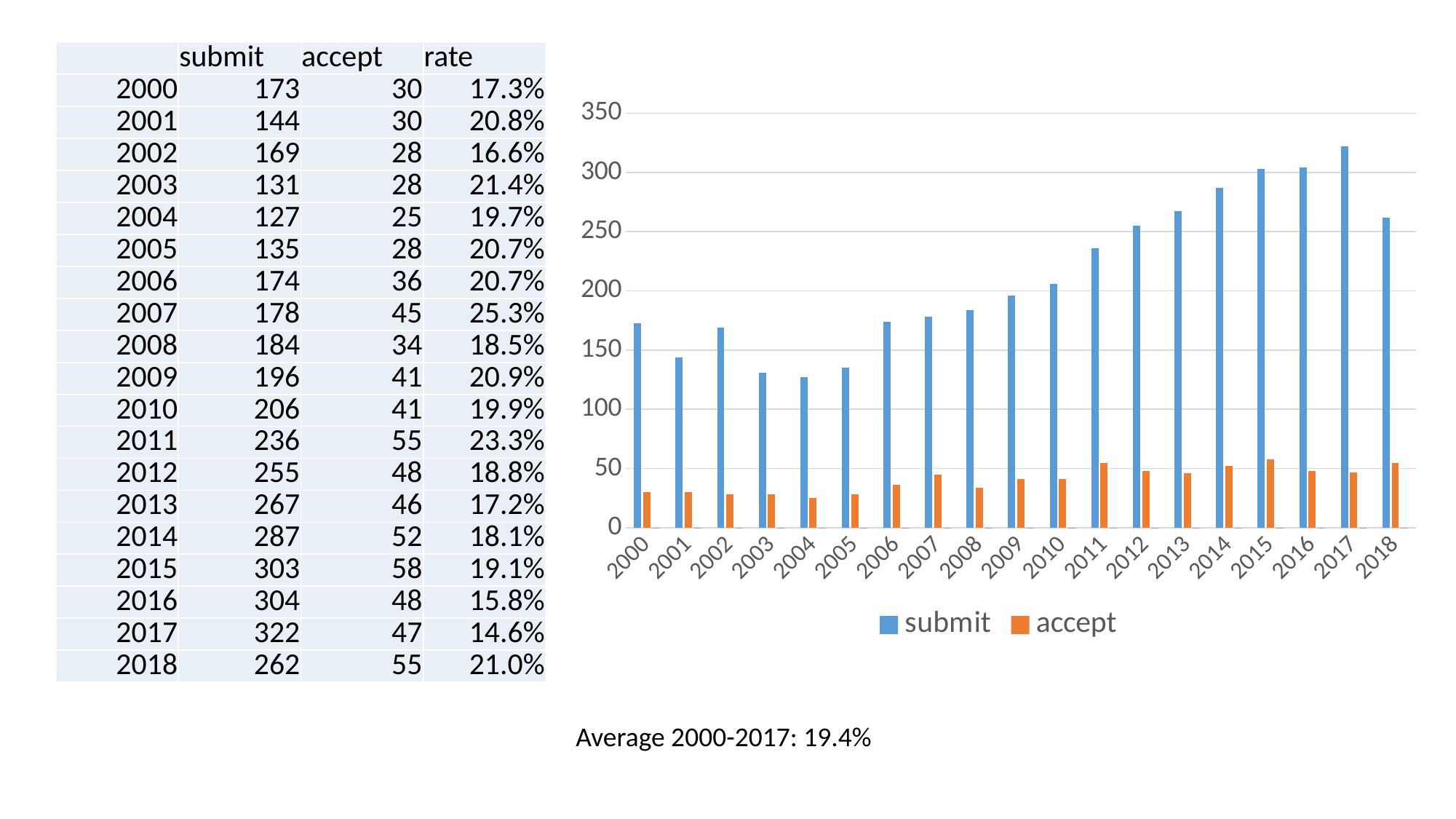
Is the submit value for 2011 greater or less than 200? greater What is the submit value for 2017? 322 What kind of chart is shown on the slide? bar chart What is the accept value for 2015? 58 Is the submit value for 2003 greater or less than 150? less How many series does the chart legend list? 2 Which year has the highest submit value in the chart? 2017 What is the difference between the submit values for 2017 and 2018? 60 Which colour represents the accept series in the chart? orange Which year has the lowest submit value in the chart? 2004 How many years are plotted along the x axis of the chart? 19 Which is larger, the submit value for 2018 or the submit value for 2016? 2016